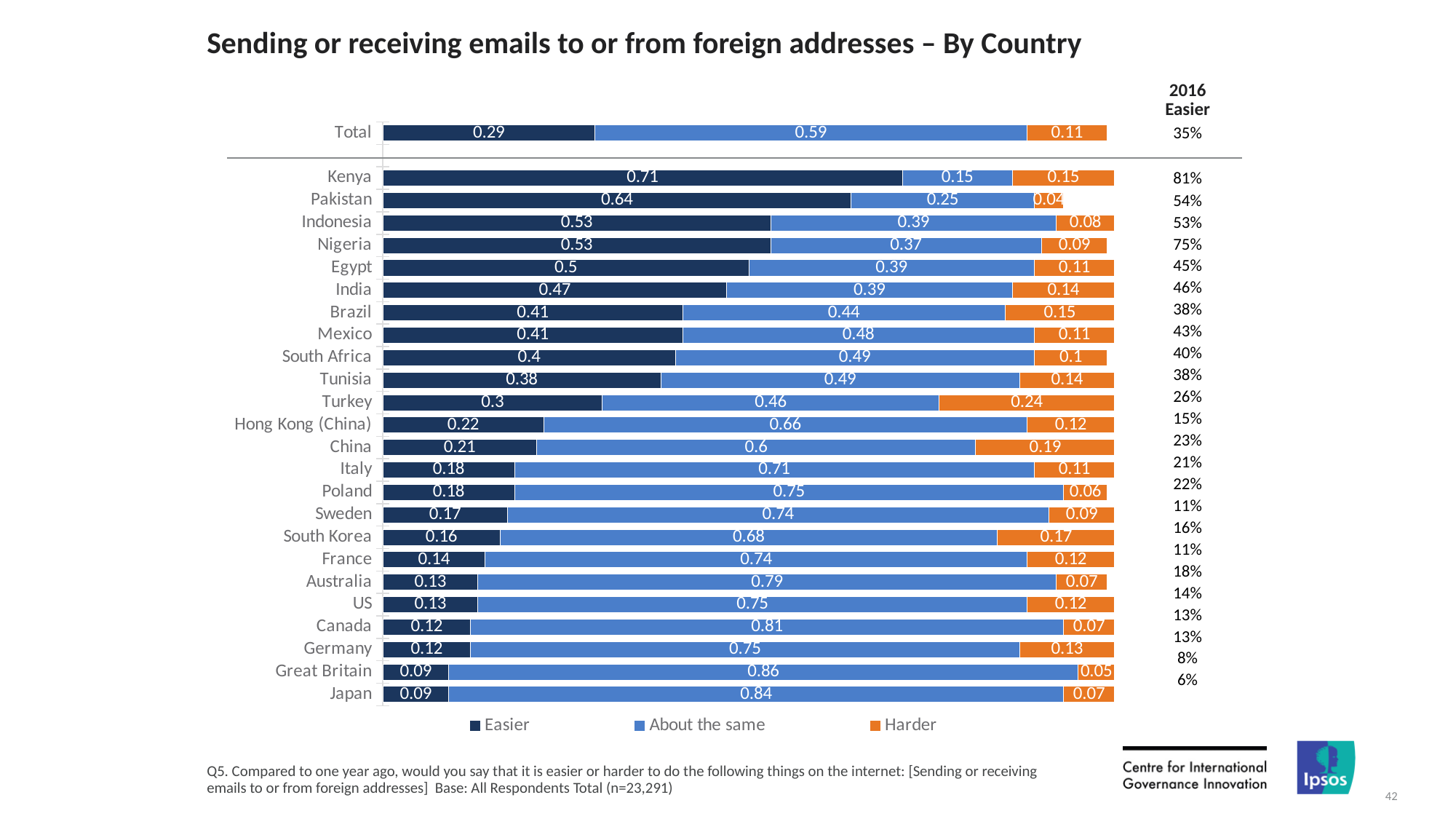
What is the 'Easier' value for Kenya? 0.71 What is the 'About the same' value for Great Britain? 0.86 What is the 'Easier' value for the Total bar? 0.29 How many countries (excluding Total) are plotted in the chart? 24 Which country has the highest 'Easier' value? Kenya What is the 'Harder' value for Turkey? 0.24 How many series does the legend list? 3 Which country has the lowest 'Harder' value? Pakistan What kind of chart is shown on the slide? Stacked bar chart Which has a larger 'About the same' value, Brazil or Mexico? Mexico What is the difference between the 'Easier' values for Kenya and Pakistan? 0.07 Which country has the highest 'Harder' value? Turkey